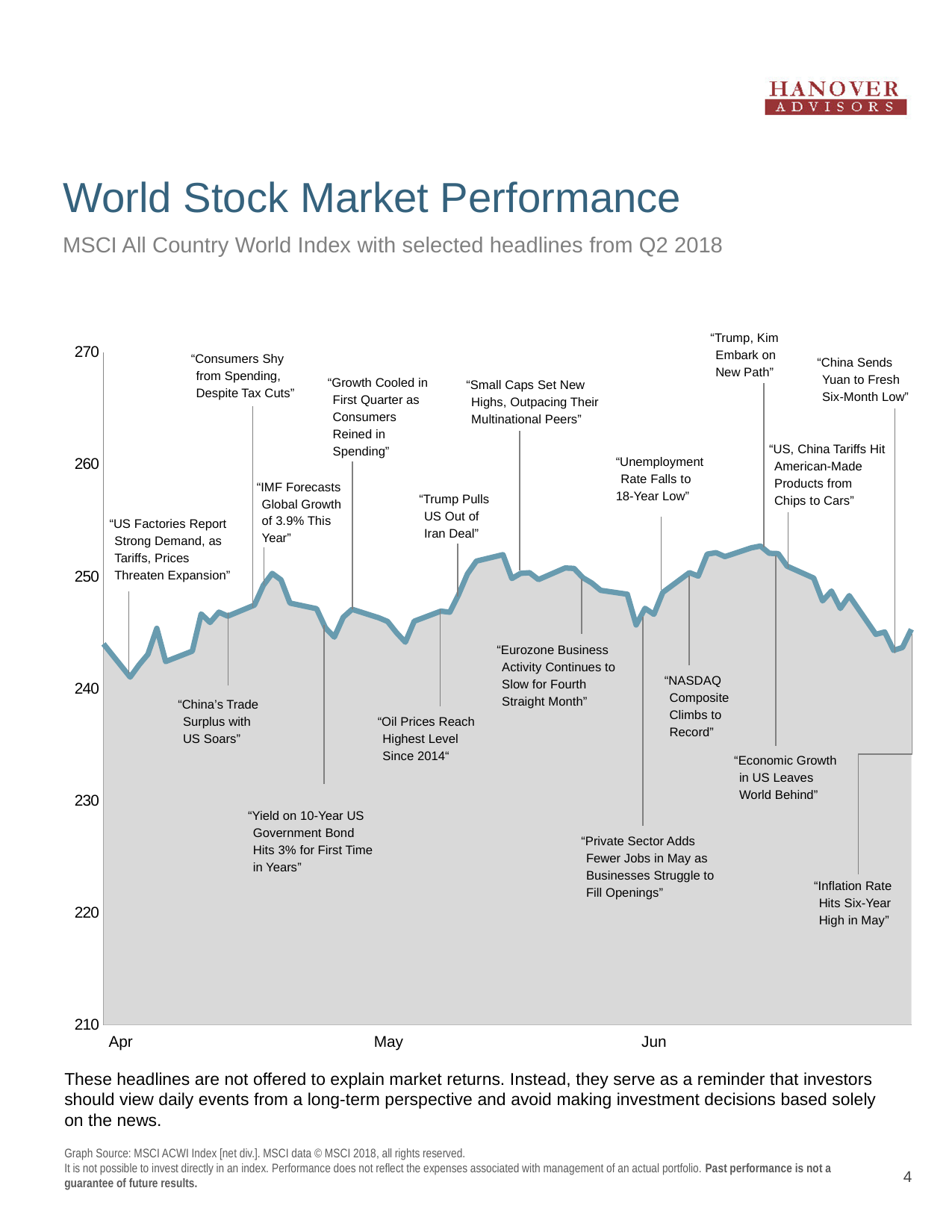
Is the index value at the start of April greater or less than 250? less Is the index value at the end of June greater or less than 240? greater What kind of chart is shown on the slide? Area chart (line with shaded area) In which month does the index reach its highest point? June Which index does the chart plot, according to the subtitle? MSCI All Country World Index What is the lowest value shown on the y axis? 210 What is the highest value shown on the y axis? 270 How many month labels are shown on the x axis? 3 Is the peak index value in mid-June greater or less than 250? greater What is the title of the chart on the slide? World Stock Market Performance Does the index rise or fall from mid-June to the end of June? fall